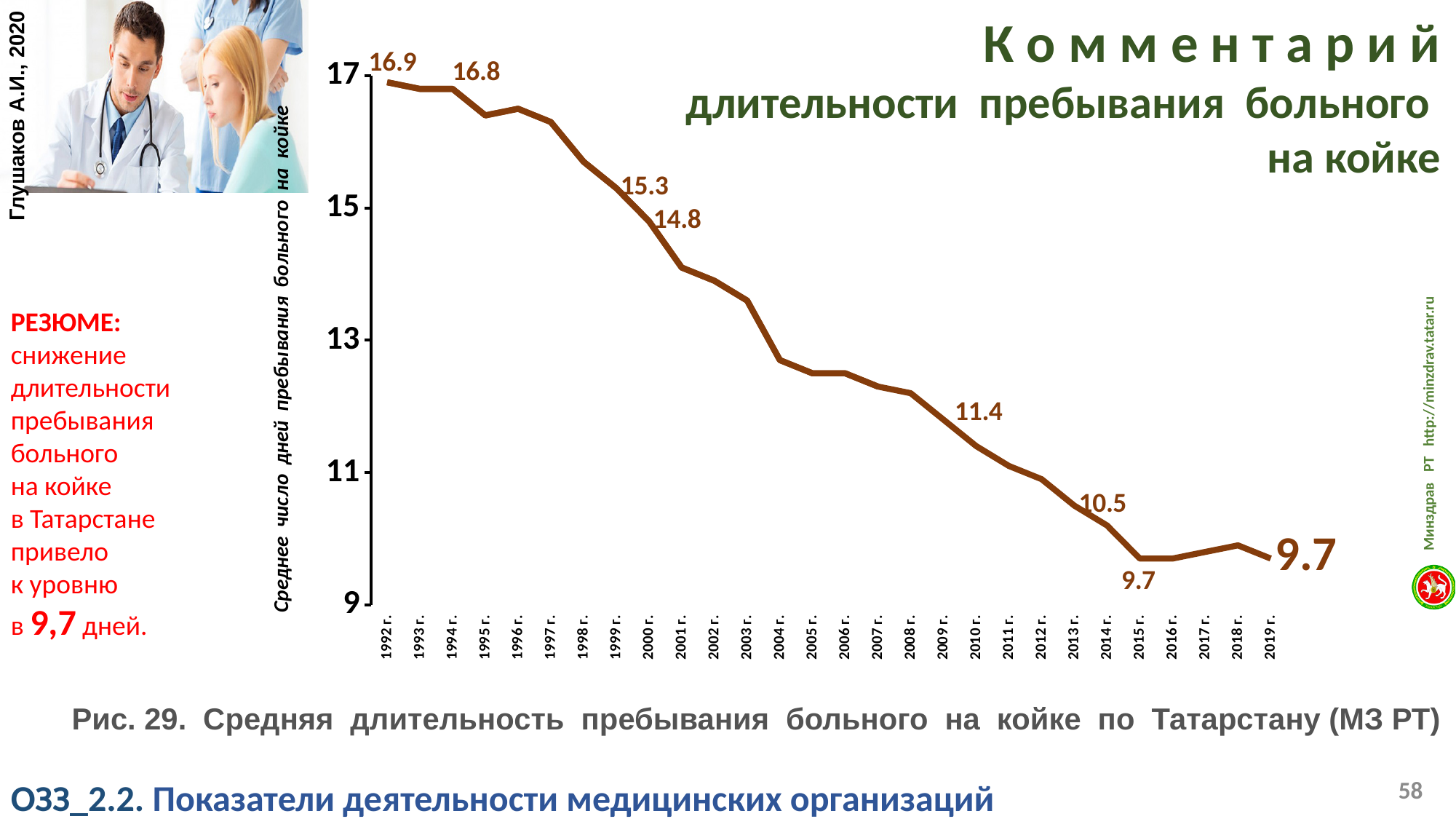
What is the difference between the values for 1992 г. and 2019 г.? 7.2 What is the average length of stay shown for 1992 г.? 16.9 Which is larger, the value for 1999 г. or the value for 2013 г.? 1999 г. Which year has the highest value on the chart? 1992 г. What value is labelled for 2019 г.? 9.7 What value is labelled for 2000 г.? 14.8 What type of chart is shown on the slide? line chart How many years are plotted on the x axis? 28 Is the value for 2004 г. greater or less than 13? less What value is labelled for 1994 г.? 16.8 Does the value rise or fall from 1992 г. to 2019 г.? fall